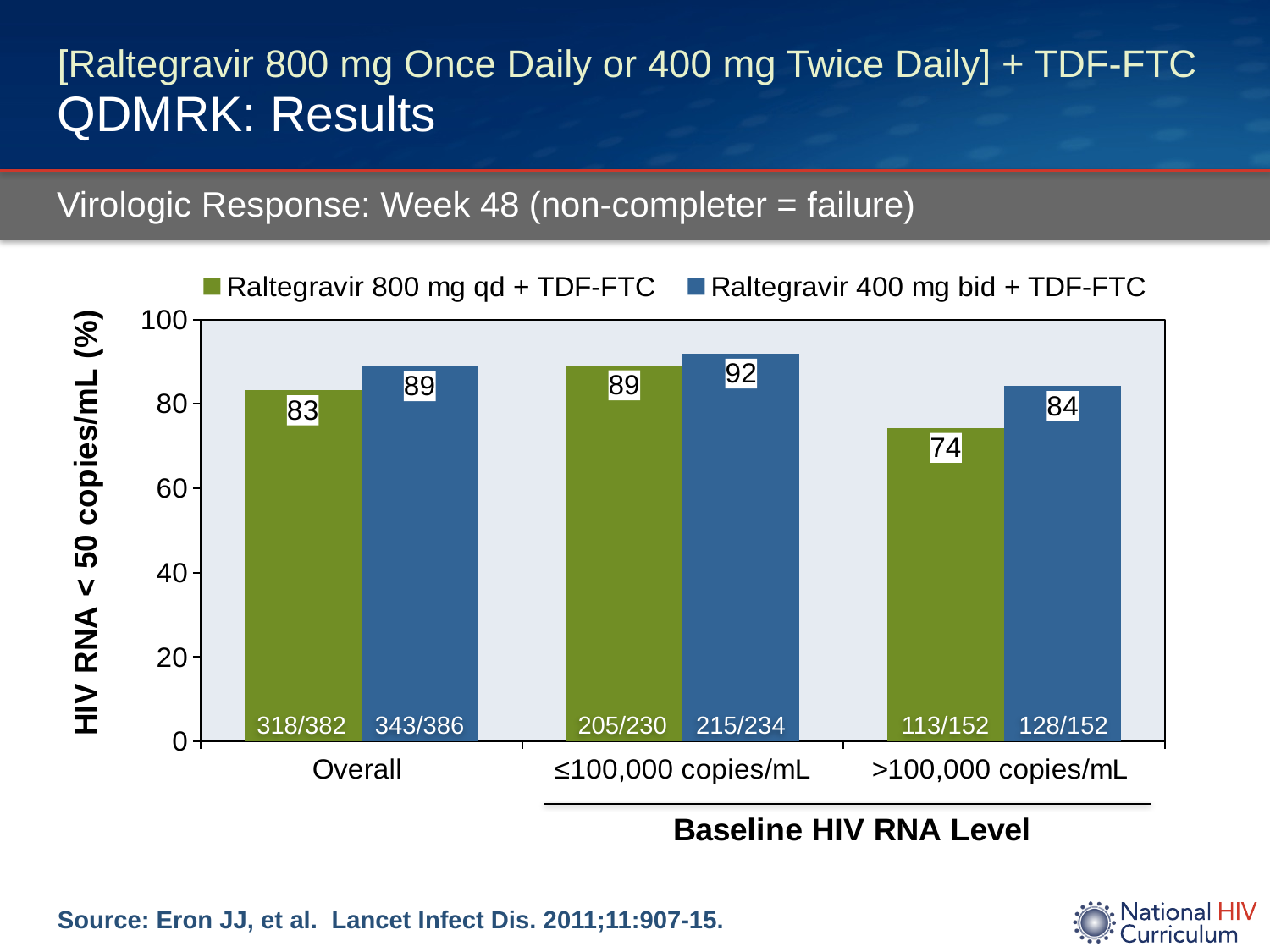
Which bar has the lowest value on the chart? Raltegravir 800 mg qd + TDF-FTC, >100,000 copies/mL How many categories are shown on the x axis? 3 What is the value for Raltegravir 400 mg bid + TDF-FTC in the ≤100,000 copies/mL category? 92 What is the difference between the two series in the >100,000 copies/mL category? 10 In the Overall category, which series has the larger value? Raltegravir 400 mg bid + TDF-FTC What kind of chart is shown on the slide? Bar chart How many series does the legend list? 2 What is the value for Raltegravir 800 mg qd + TDF-FTC in the >100,000 copies/mL category? 74 What fraction is printed on the Raltegravir 400 mg bid + TDF-FTC bar in the Overall category? 343/386 What is the value for Raltegravir 800 mg qd + TDF-FTC in the Overall category? 83 Which bar has the highest value on the chart? Raltegravir 400 mg bid + TDF-FTC, ≤100,000 copies/mL What is the y-axis label of the chart? HIV RNA < 50 copies/mL (%)